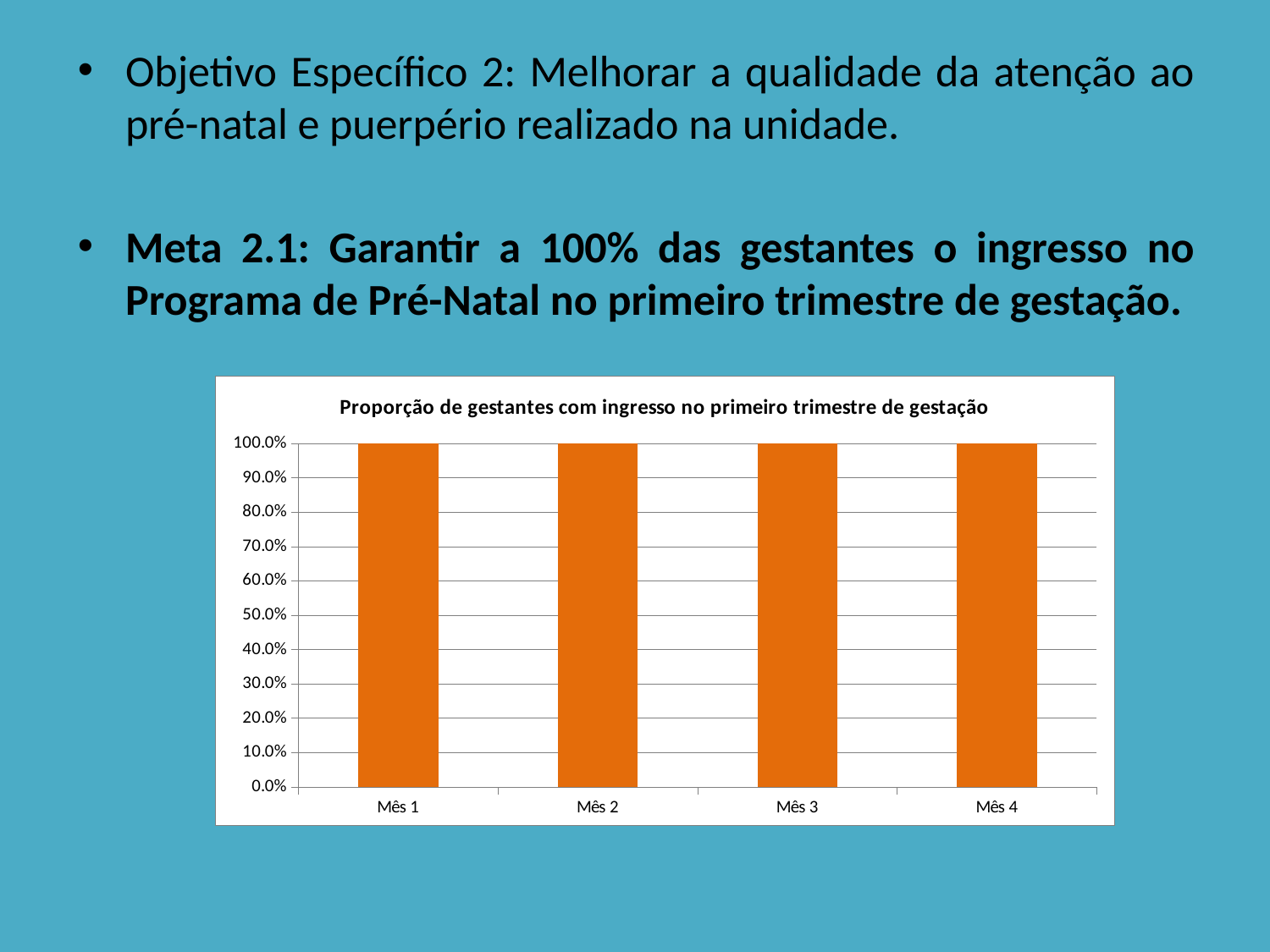
Is the value for Mês 4 greater or less than 50.0%? greater What is the difference between the values for Mês 1 and Mês 4? 0.0% How many categories are shown on the x axis of the chart? 4 What colour are the bars in the chart? orange What kind of chart is shown on the slide? bar chart What is the value for Mês 1 in the chart? 100.0% What is the value for Mês 4 in the chart? 100.0% Is the value for Mês 2 greater or less than 90.0%? greater What is the highest value shown on the y axis of the chart? 100.0% What is the value for Mês 3 in the chart? 100.0% What is the title of the chart? Proporção de gestantes com ingresso no primeiro trimestre de gestação Do the values rise, fall, or stay the same from Mês 1 to Mês 4? stay the same